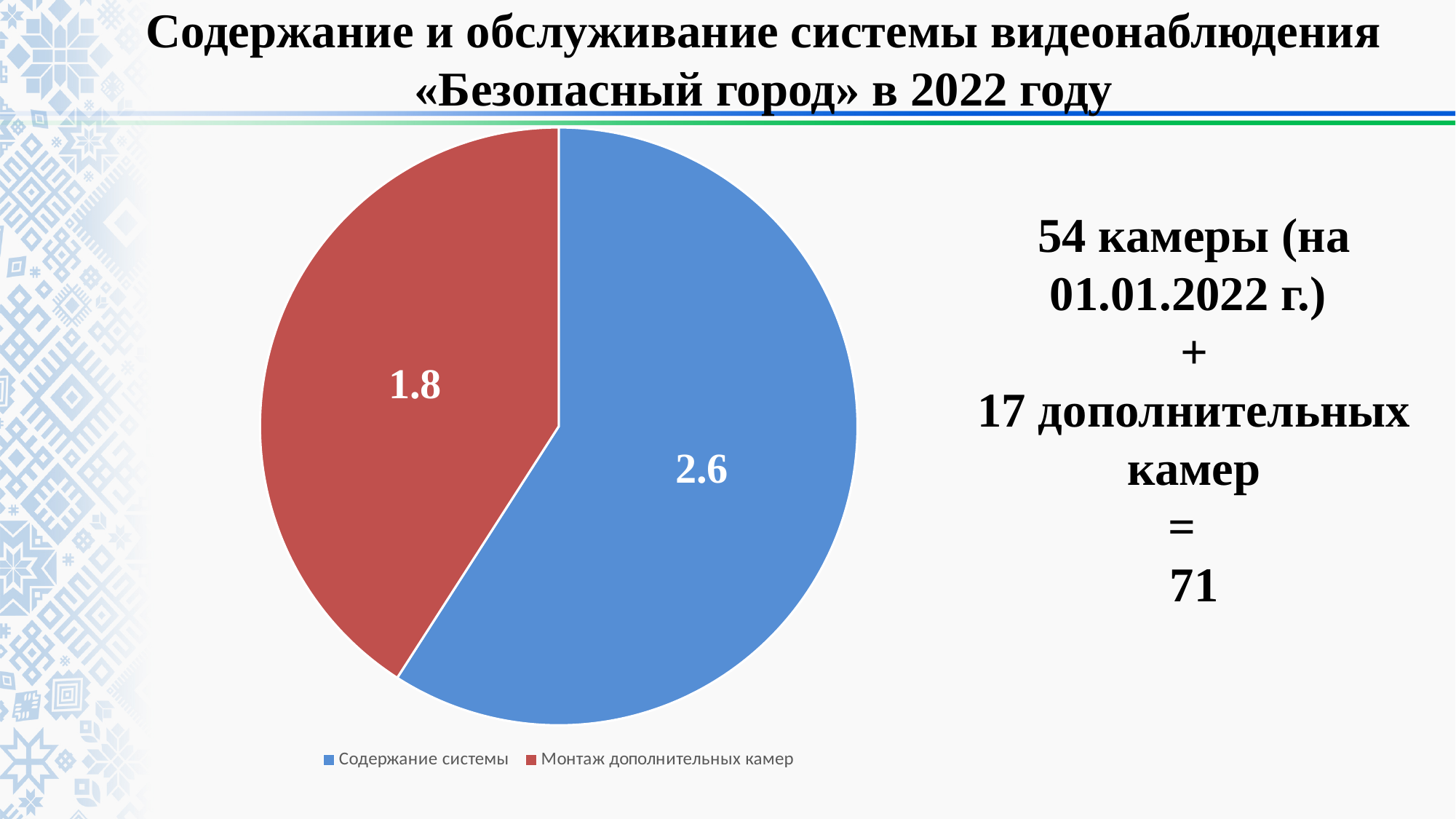
How many entries does the legend of the pie chart list? 2 What is the value for "Монтаж дополнительных камер" in the pie chart? 1.8 What is the difference between the values for "Содержание системы" and "Монтаж дополнительных камер"? 0.8 Which is larger: "Содержание системы" or "Монтаж дополнительных камер"? Содержание системы Which slice of the pie chart is the smallest? Монтаж дополнительных камер What type of chart is shown on the slide? pie chart What is the total of the two values shown in the pie chart? 4.4 What colour is the "Содержание системы" slice in the pie chart? blue Which slice of the pie chart is the largest? Содержание системы How many slices does the pie chart have? 2 What colour is the "Монтаж дополнительных камер" slice in the pie chart? red What is the value for "Содержание системы" in the pie chart? 2.6